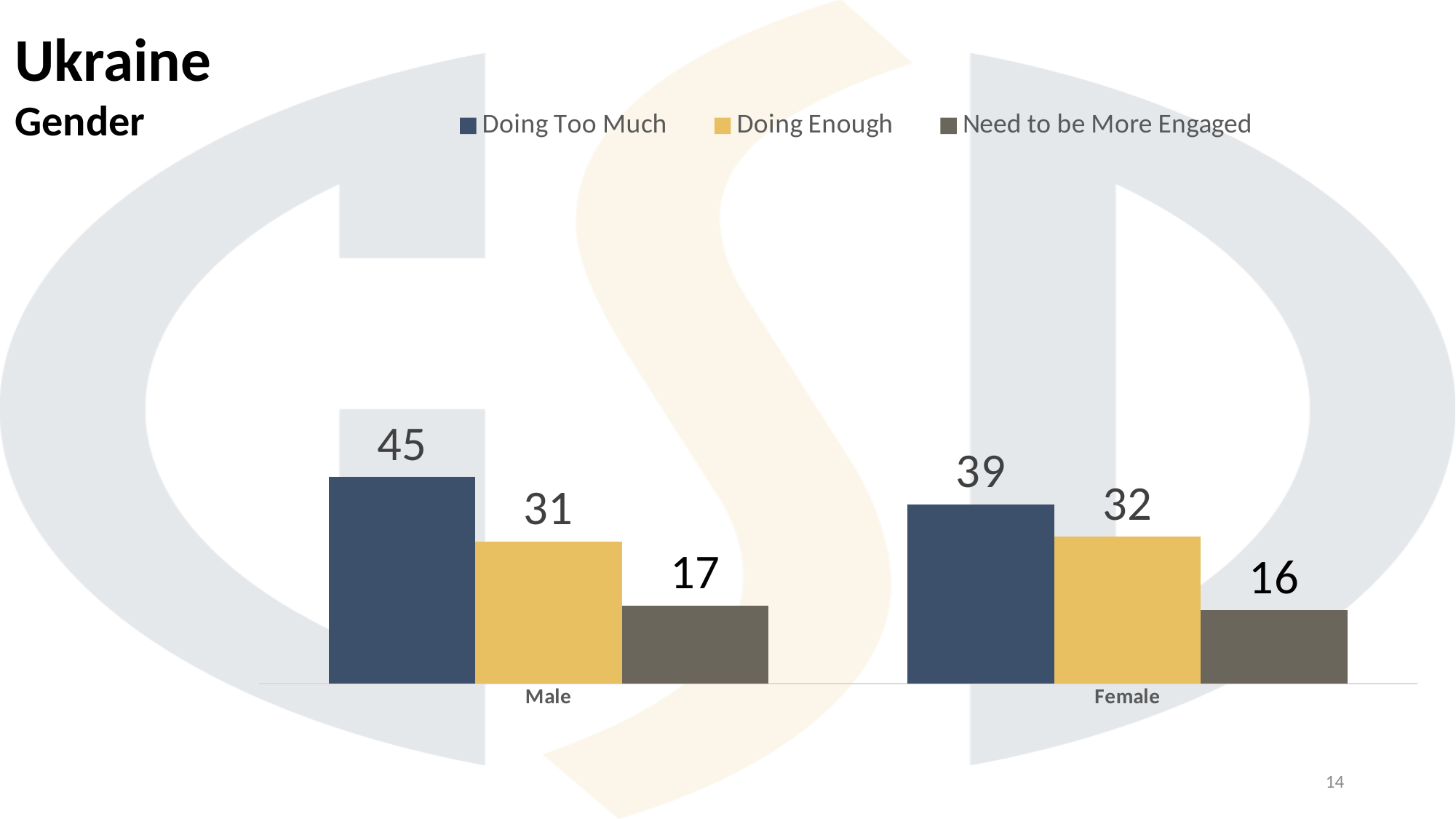
How many series does the legend list? 3 Which series has the lowest value for the Male category? Need to be More Engaged What kind of chart is shown on the slide? Bar chart What is the value for "Doing Enough" among females? 32 How many categories are shown on the x axis? 2 Which is larger: "Doing Enough" for males or "Doing Enough" for females? Female Which series has the highest value for the Female category? Doing Too Much What is the difference between the "Doing Too Much" values for males and females? 6 Which series is shown in yellow in the legend? Doing Enough What is the value for "Doing Too Much" among females? 39 What is the value for "Need to be More Engaged" among males? 17 What is the value for "Doing Too Much" among males? 45